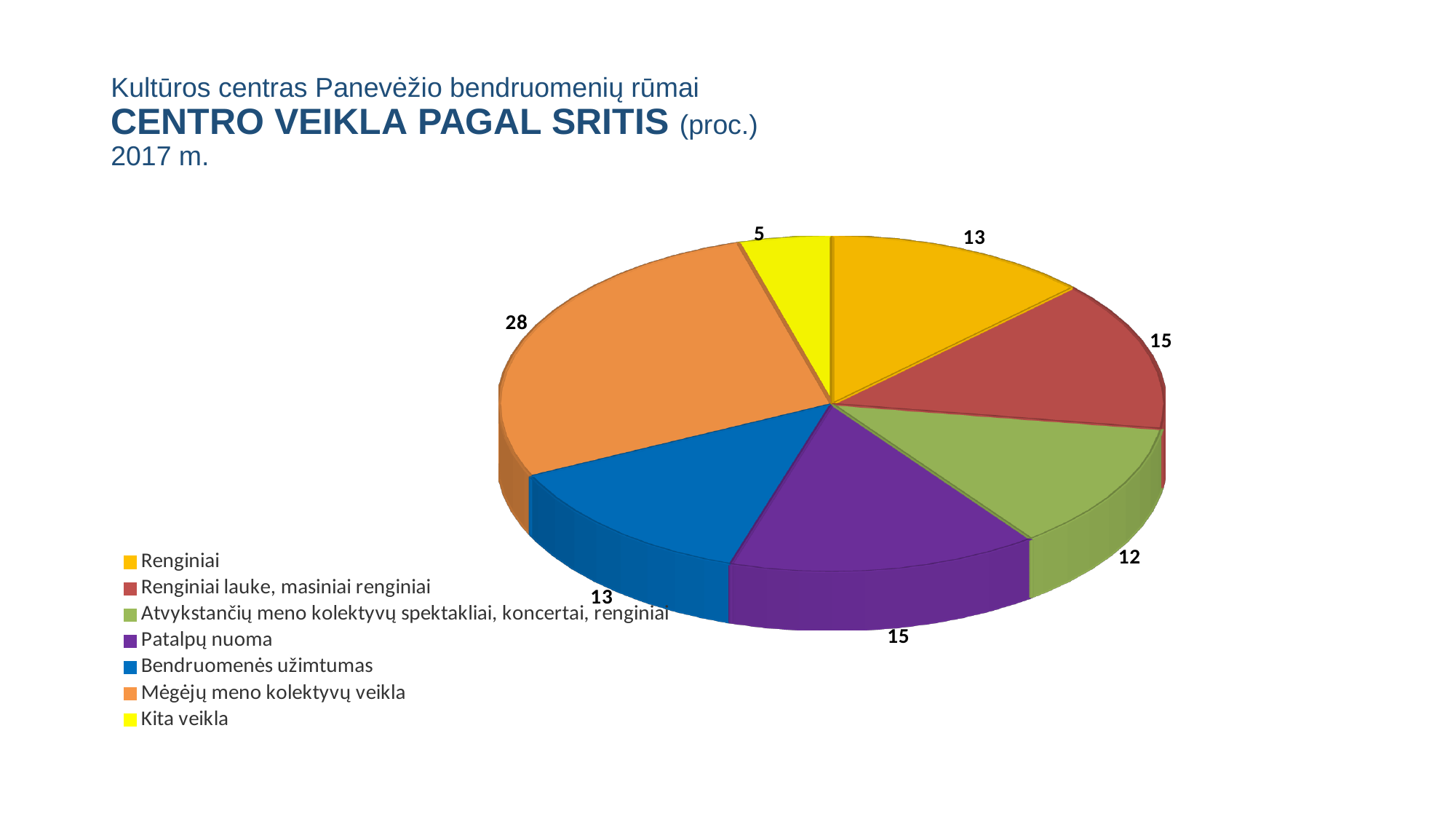
Which category has the smallest slice? Kita veikla What type of chart is shown on the slide? pie chart What is the value for Patalpų nuoma? 15 What is the value for Bendruomenės užimtumas? 13 What is the value for Atvykstančių meno kolektyvų spektakliai, koncertai, renginiai? 12 What is the value for Mėgėjų meno kolektyvų veikla? 28 Which category has the largest slice? Mėgėjų meno kolektyvų veikla How many categories does the pie chart have? 7 What is the value for Kita veikla? 5 What is the difference between the values for Mėgėjų meno kolektyvų veikla and Kita veikla? 23 What colour is the slice for Patalpų nuoma? purple Which is larger, the value for Renginiai lauke, masiniai renginiai or the value for Atvykstančių meno kolektyvų spektakliai, koncertai, renginiai? Renginiai lauke, masiniai renginiai